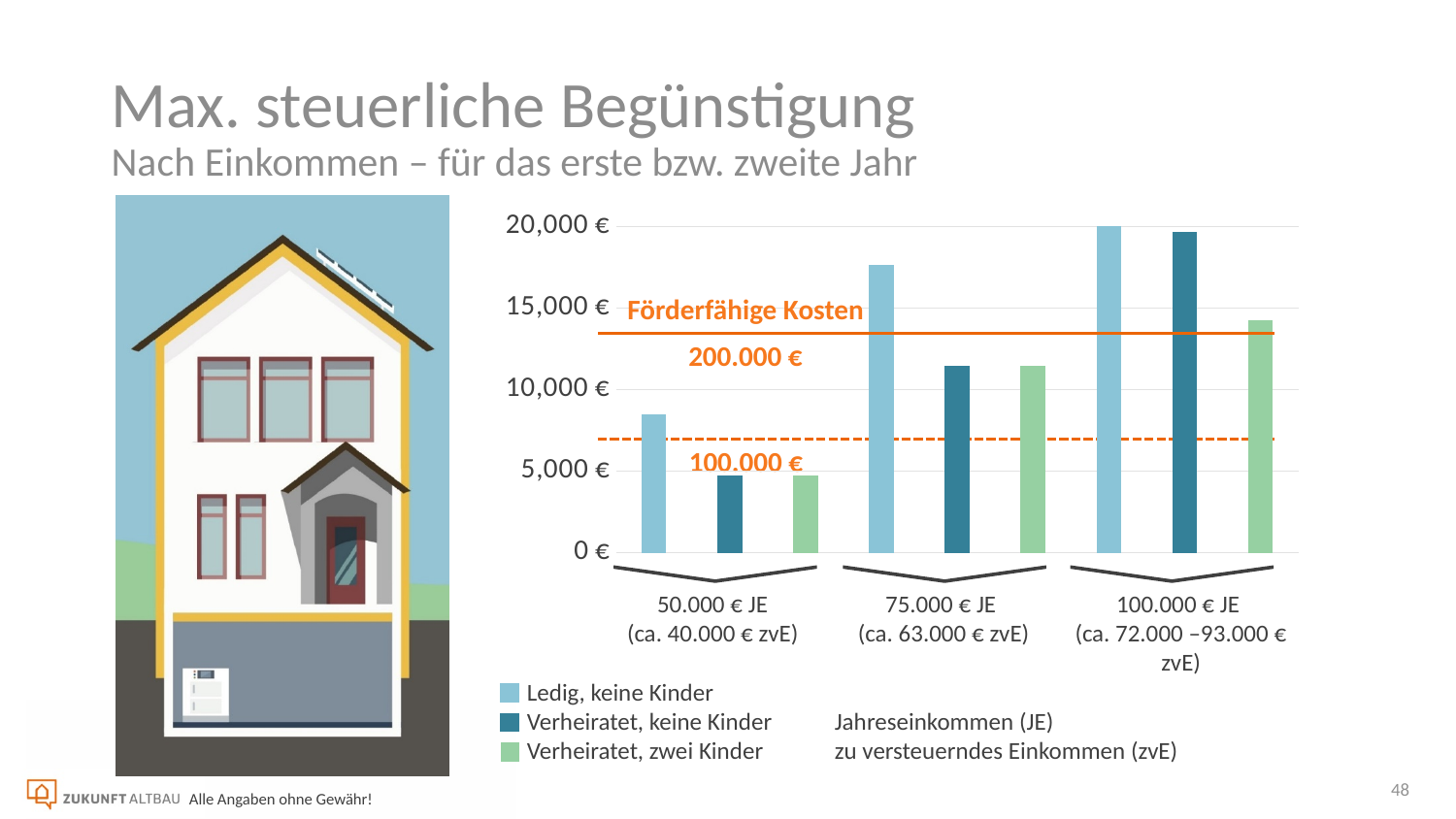
Do the values for Ledig, keine Kinder rise or fall as income increases along the x axis? rise How many income categories are shown on the x axis? 3 Is the value for Ledig, keine Kinder at 50.000 € JE greater or less than 5,000 €? greater In which income category is the bar for Ledig, keine Kinder the lowest? 50.000 € JE Is the value for Verheiratet, zwei Kinder at 100.000 € JE greater or less than 15,000 €? less Is the value for Verheiratet, keine Kinder at 75.000 € JE greater or less than 10,000 €? greater What kind of chart is shown on the slide? bar chart Which series has the highest bar in the 100.000 € JE category? Ledig, keine Kinder How many series does the legend list? 3 At 50.000 € JE, which is larger: the bar for Ledig, keine Kinder or the bar for Verheiratet, keine Kinder? Ledig, keine Kinder What value is labelled on the solid orange line marked Förderfähige Kosten? 200.000 €